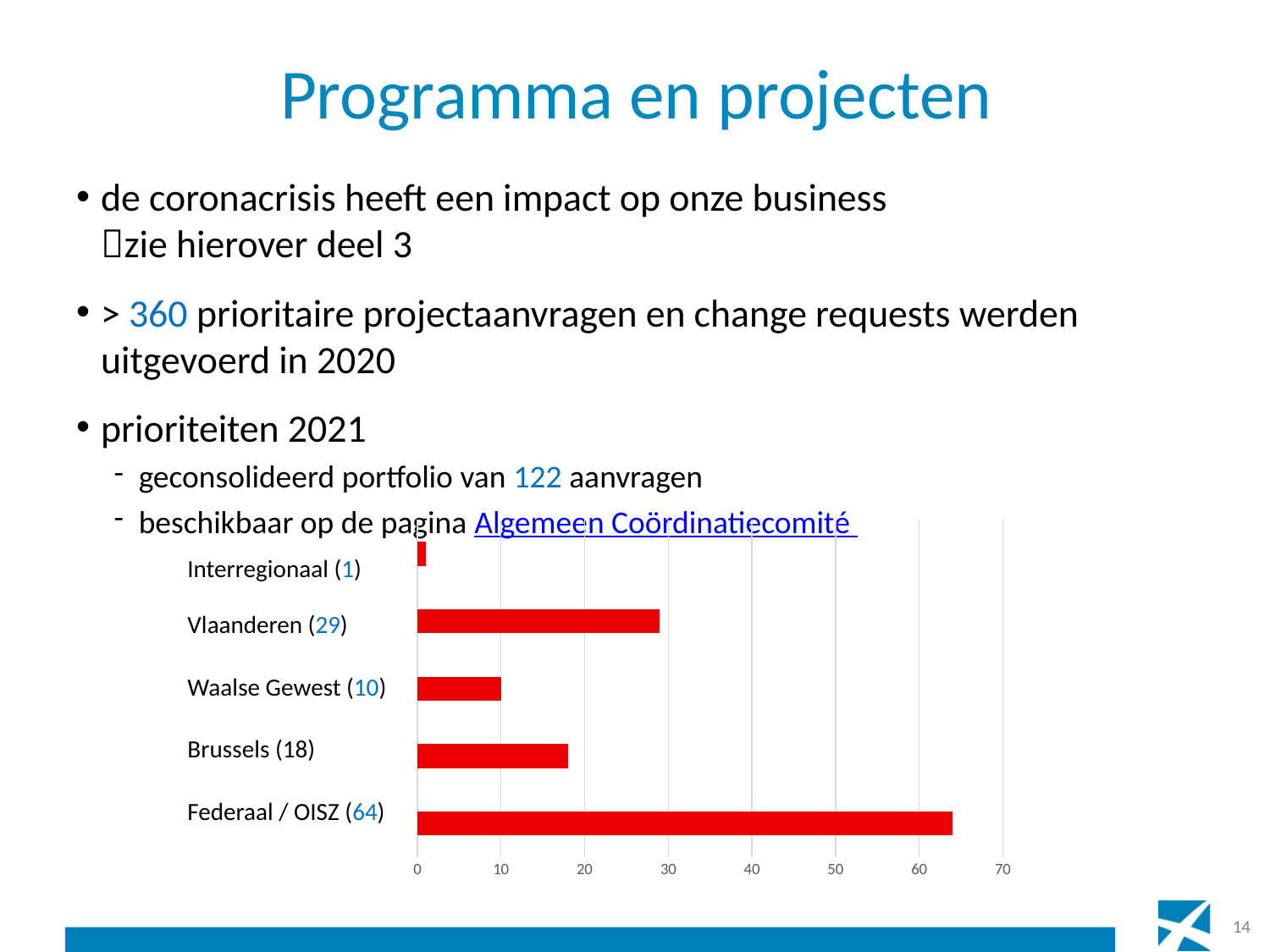
Which category has the lowest value? Interregionaal What is the difference between the values for Federaal / OISZ and Vlaanderen? 35 What is the highest tick value shown on the horizontal axis? 70 Which category has the highest value? Federaal / OISZ What is the value for Vlaanderen? 29 Is the value for Vlaanderen greater or less than 20? greater What kind of chart is shown on the slide? bar chart Which is larger, the value for Brussels or the value for Waalse Gewest? Brussels What is the value for Federaal / OISZ? 64 How many categories does the bar chart show? 5 What is the value for Brussels? 18 What is the value for Waalse Gewest? 10